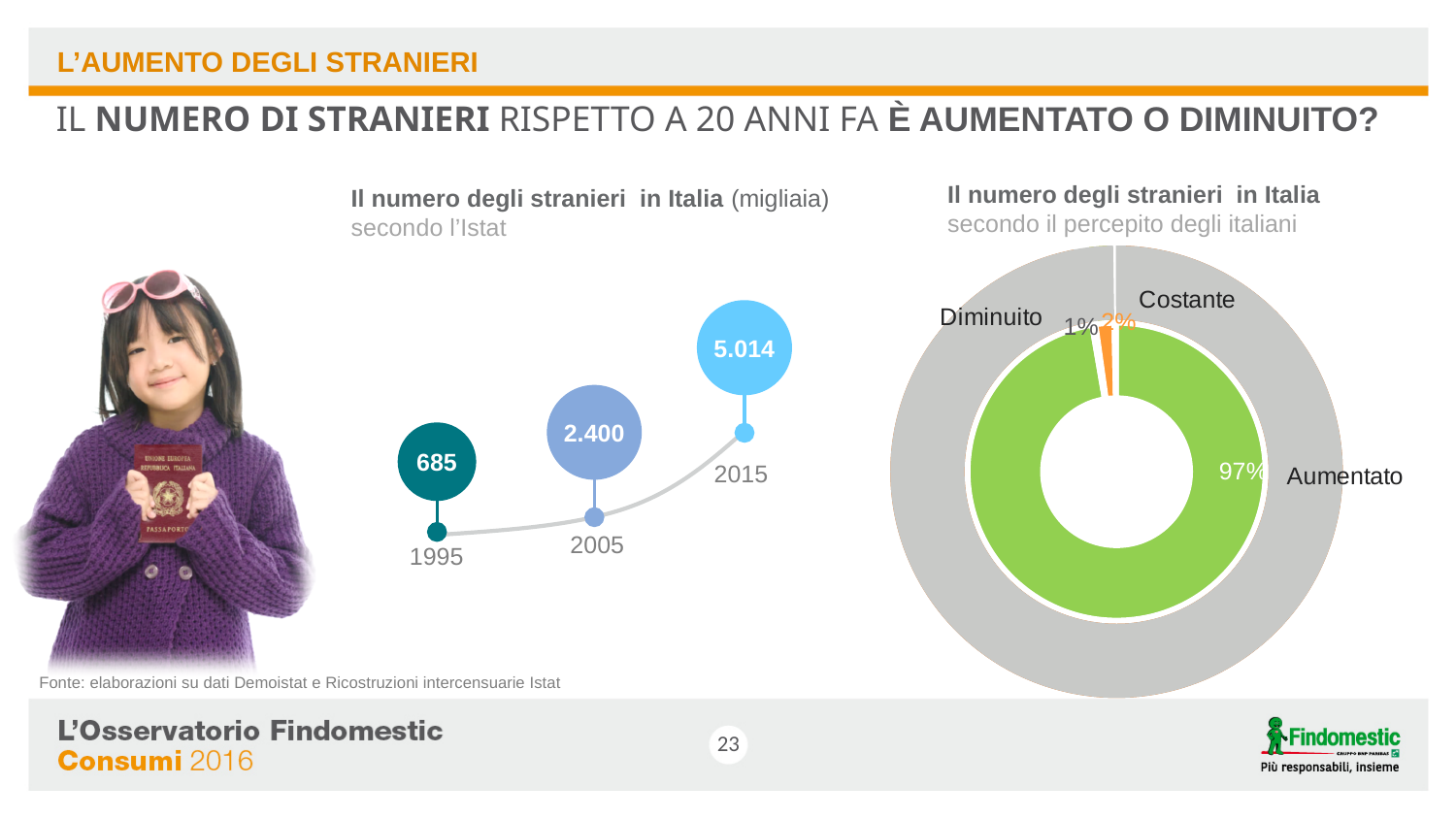
In the chart 'Il numero degli stranieri in Italia secondo il percepito degli italiani', what is the value for 'Diminuito'? 1% In the chart 'Il numero degli stranieri in Italia (migliaia) secondo l'Istat', what is the difference between the 2015 and 1995 values? 4.329 In the chart 'Il numero degli stranieri in Italia (migliaia) secondo l'Istat', what is the value for 1995? 685 In the chart 'Il numero degli stranieri in Italia (migliaia) secondo l'Istat', which year has the lowest value? 1995 What kind of chart is 'Il numero degli stranieri in Italia secondo il percepito degli italiani'? doughnut chart In the chart 'Il numero degli stranieri in Italia (migliaia) secondo l'Istat', do the values rise or fall from 1995 to 2015? rise In the chart 'Il numero degli stranieri in Italia secondo il percepito degli italiani', what share of respondents answered 'Aumentato'? 97% In the chart 'Il numero degli stranieri in Italia (migliaia) secondo l'Istat', which year has the highest value? 2015 In the chart 'Il numero degli stranieri in Italia (migliaia) secondo l'Istat', what is the value for 2015? 5.014 In the chart 'Il numero degli stranieri in Italia (migliaia) secondo l'Istat', what is the value for 2005? 2.400 How many data points are plotted in the chart 'Il numero degli stranieri in Italia (migliaia) secondo l'Istat'? 3 In the chart 'Il numero degli stranieri in Italia secondo il percepito degli italiani', which category is the largest? Aumentato